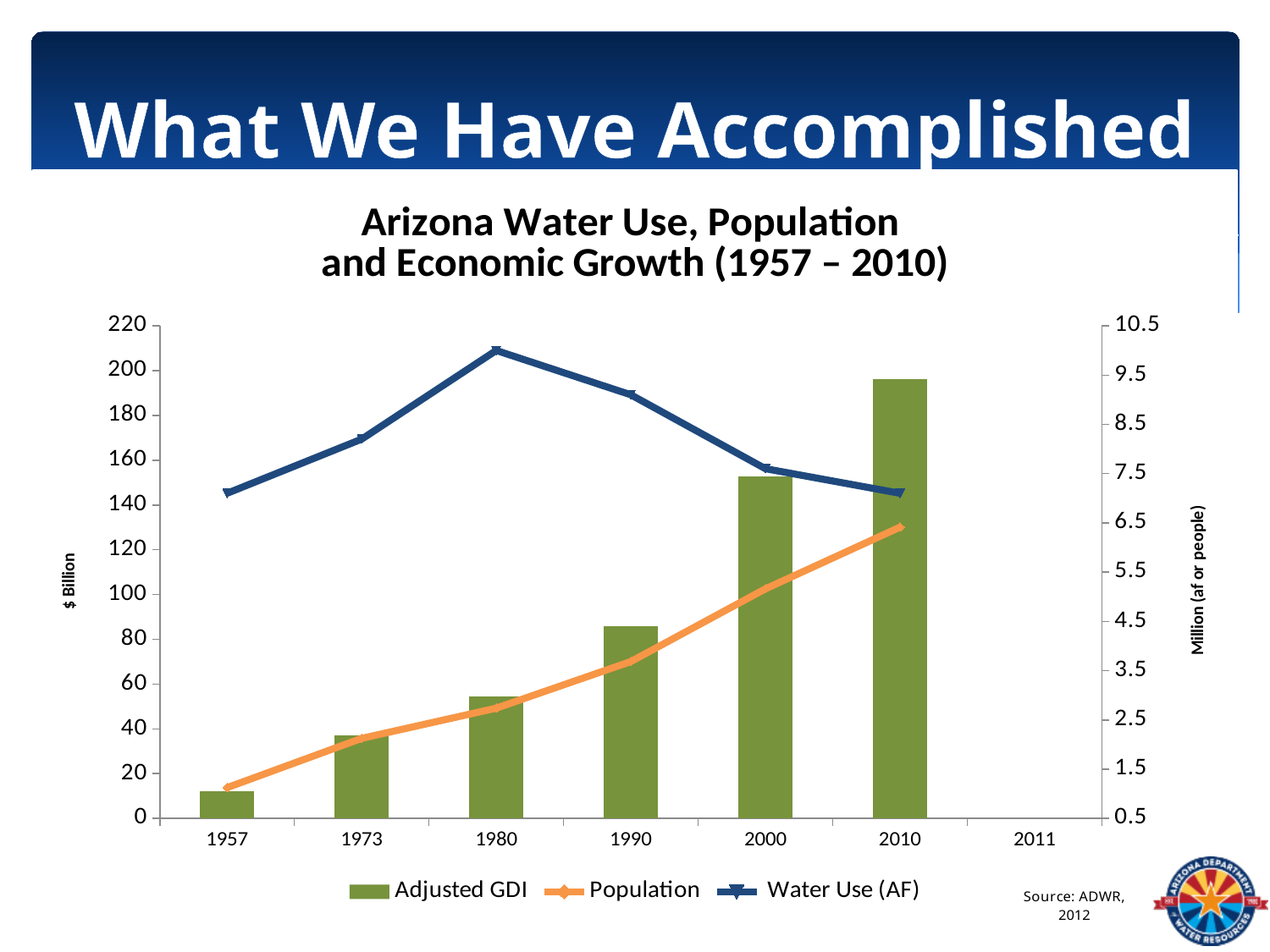
What kind of chart is shown on the slide? A combination bar and line chart What is the title of the chart? Arizona Water Use, Population and Economic Growth (1957 – 2010) Does the Population line rise or fall from 1957 to 2010? Rises In which year is the Adjusted GDI bar the shortest? 1957 In which year is the Adjusted GDI bar the tallest? 2010 Is the Adjusted GDI value for 1990 greater or less than 100? less How many series does the legend list? 3 How many Adjusted GDI bars are plotted on the chart? 6 Is the Adjusted GDI value for 2010 greater or less than 180? greater Which year has the larger Adjusted GDI bar, 1990 or 2000? 2000 In which year does the Water Use (AF) line reach its highest point? 1980 Does the Water Use (AF) line rise or fall from 1980 to 2010? Falls